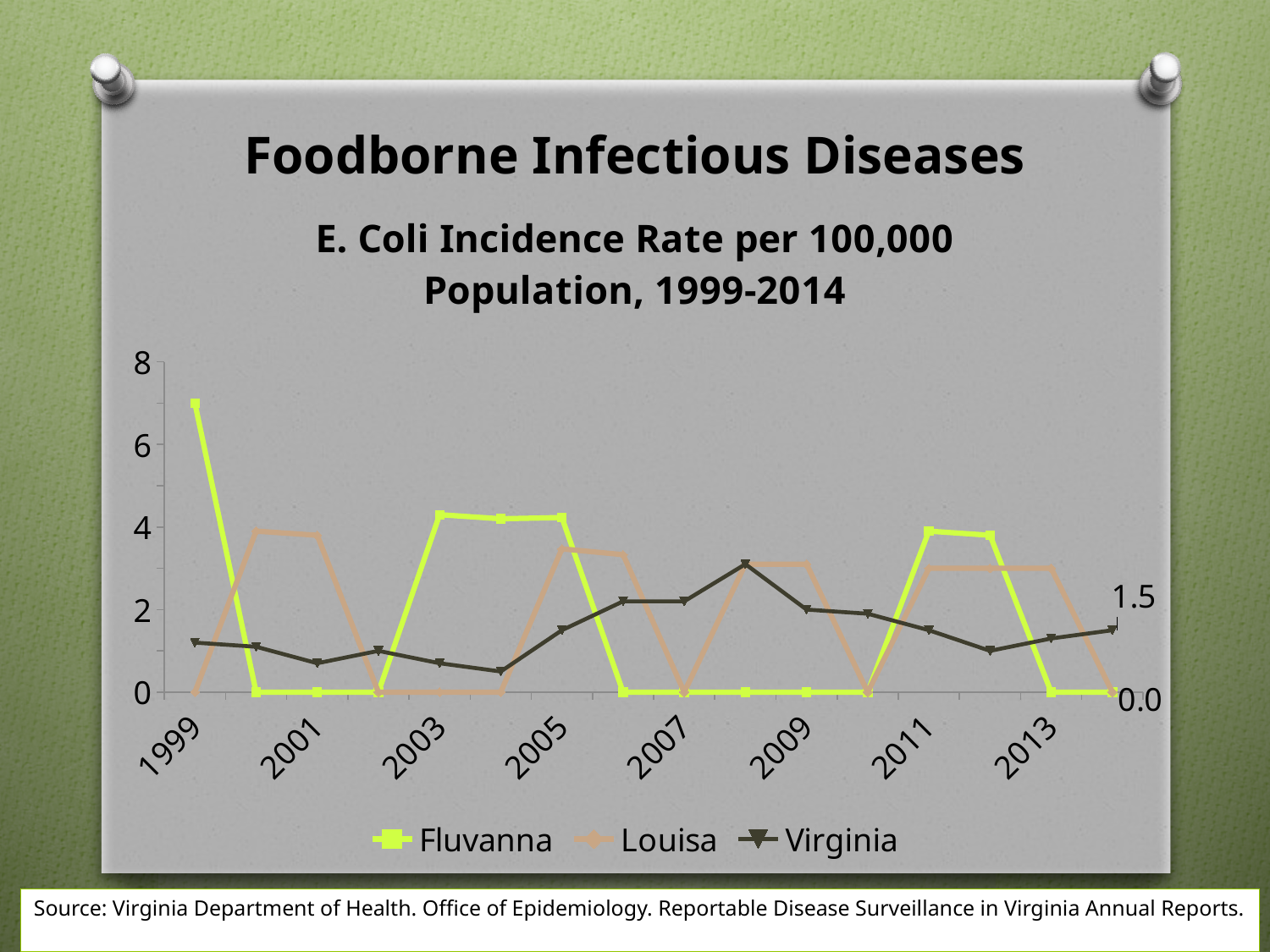
Which series has the highest value in 1999? Fluvanna In 2008, which is larger, the value for Virginia or the value for Fluvanna? Virginia Which series has the lowest value in 2000? Fluvanna Which series are listed in the legend? Fluvanna, Louisa, Virginia Is the value for Louisa in 2000 greater or less than 2? greater Is the value for Fluvanna in 1999 greater or less than 6? greater Is the value for Virginia in 2008 greater or less than 2? greater What kind of chart is shown on the slide? line chart How many series does the legend list? 3 What is the chart's title? E. Coli Incidence Rate per 100,000 Population, 1999-2014 What is the value for Fluvanna in 2014? 0.0 What is the value for Virginia in 2014? 1.5